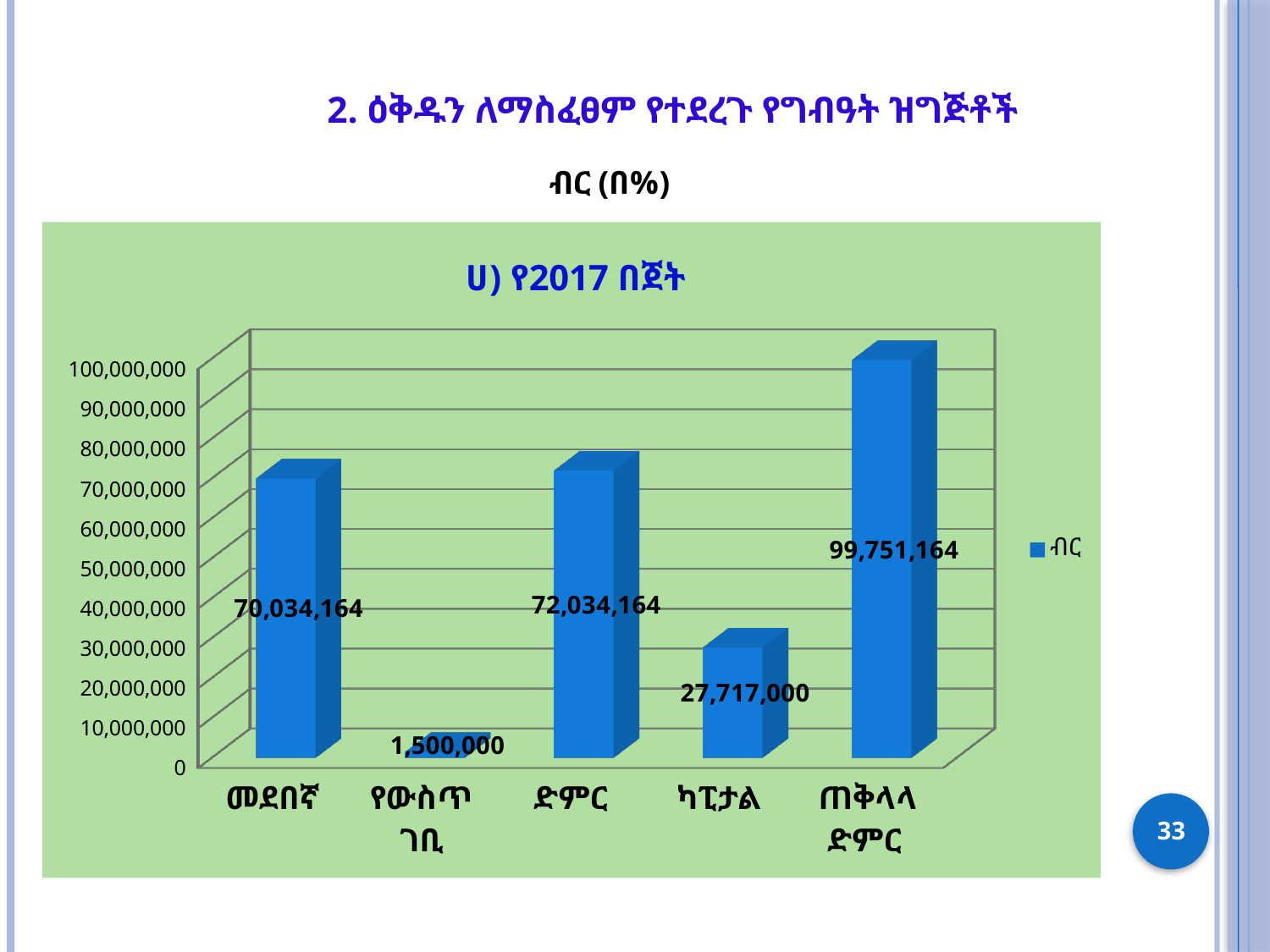
Which category has the highest value in the chart? ጠቅላላ ድምር Is the value for ካፒታል greater or less than 30,000,000? less Which is larger, the value for ካፒታል or the value for መደበኛ? መደበኛ How many categories are shown on the x axis of the chart? 5 What type of chart is shown on the slide? bar chart What is the difference between the values for ድምር and መደበኛ? 2,000,000 What is the value for ጠቅላላ ድምር in the chart? 99,751,164 What is the value for መደበኛ in the chart? 70,034,164 What is the value for የውስጥ ገቢ in the chart? 1,500,000 What is the value for ካፒታል in the chart? 27,717,000 Which category has the lowest value in the chart? የውስጥ ገቢ What is the title of the chart? ሀ) የ2017 በጀት